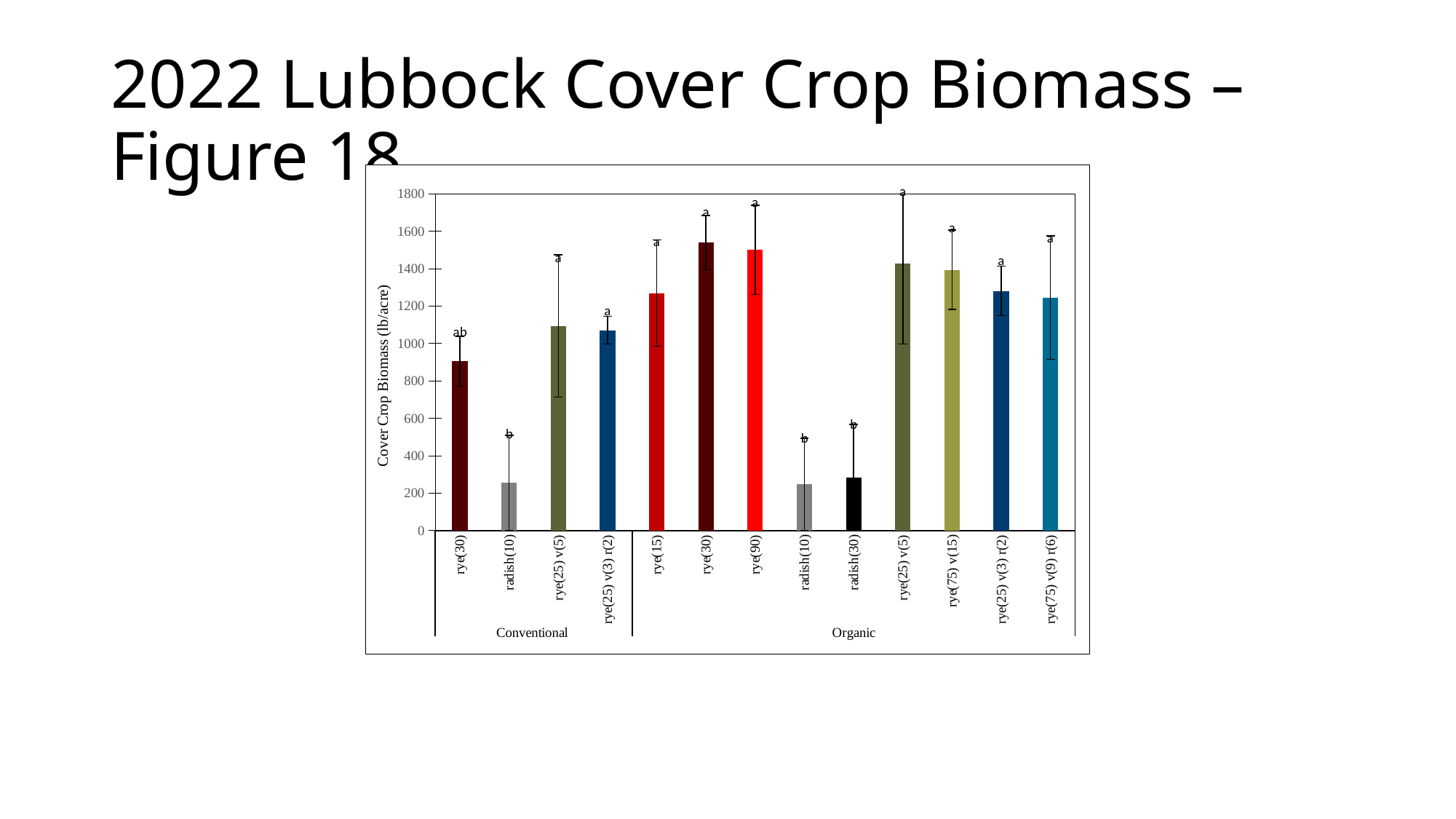
Is the value for radish(10) in the Conventional group greater or less than 400? less What is the label of the vertical axis? Cover Crop Biomass (lb/acre) Is the value for rye(25) v(5) in the Organic group greater or less than 1200? greater How many bars are plotted in the chart? 13 What kind of chart is shown on the slide? bar chart Which is larger, rye(30) in the Conventional group or rye(30) in the Organic group? rye(30) in the Organic group How many bars are in the Conventional group? 4 How many bars are in the Organic group? 9 Which is larger, rye(15) or radish(30) in the Organic group? rye(15) Is the value for rye(30) in the Conventional group greater or less than 1000? less What are the two group labels shown beneath the x axis? Conventional and Organic